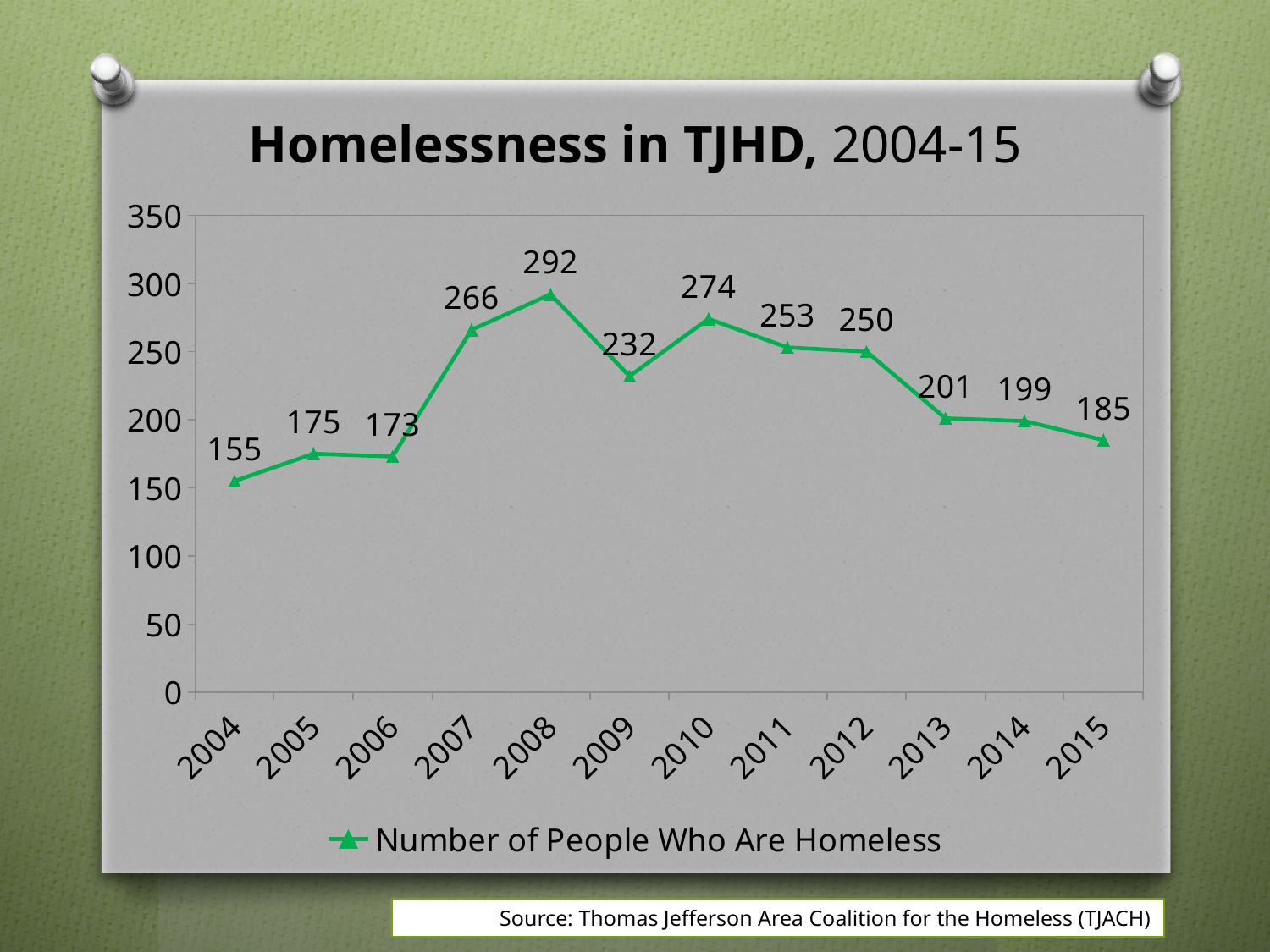
What is the difference between the number of people who are homeless in 2015 and in 2004? 30 What was the number of people who are homeless in 2008? 292 Which year had more people who are homeless, 2010 or 2012? 2010 Which year had the highest number of people who are homeless? 2008 What was the number of people who are homeless in 2004? 155 What kind of chart is shown on the slide? Line chart How many years are plotted on the chart? 12 How many series does the legend list? 1 What was the number of people who are homeless in 2015? 185 What is the difference between the number of people who are homeless in 2008 and in 2009? 60 Did the number of people who are homeless rise or fall from 2012 to 2015? Fall Which year had the lowest number of people who are homeless? 2004